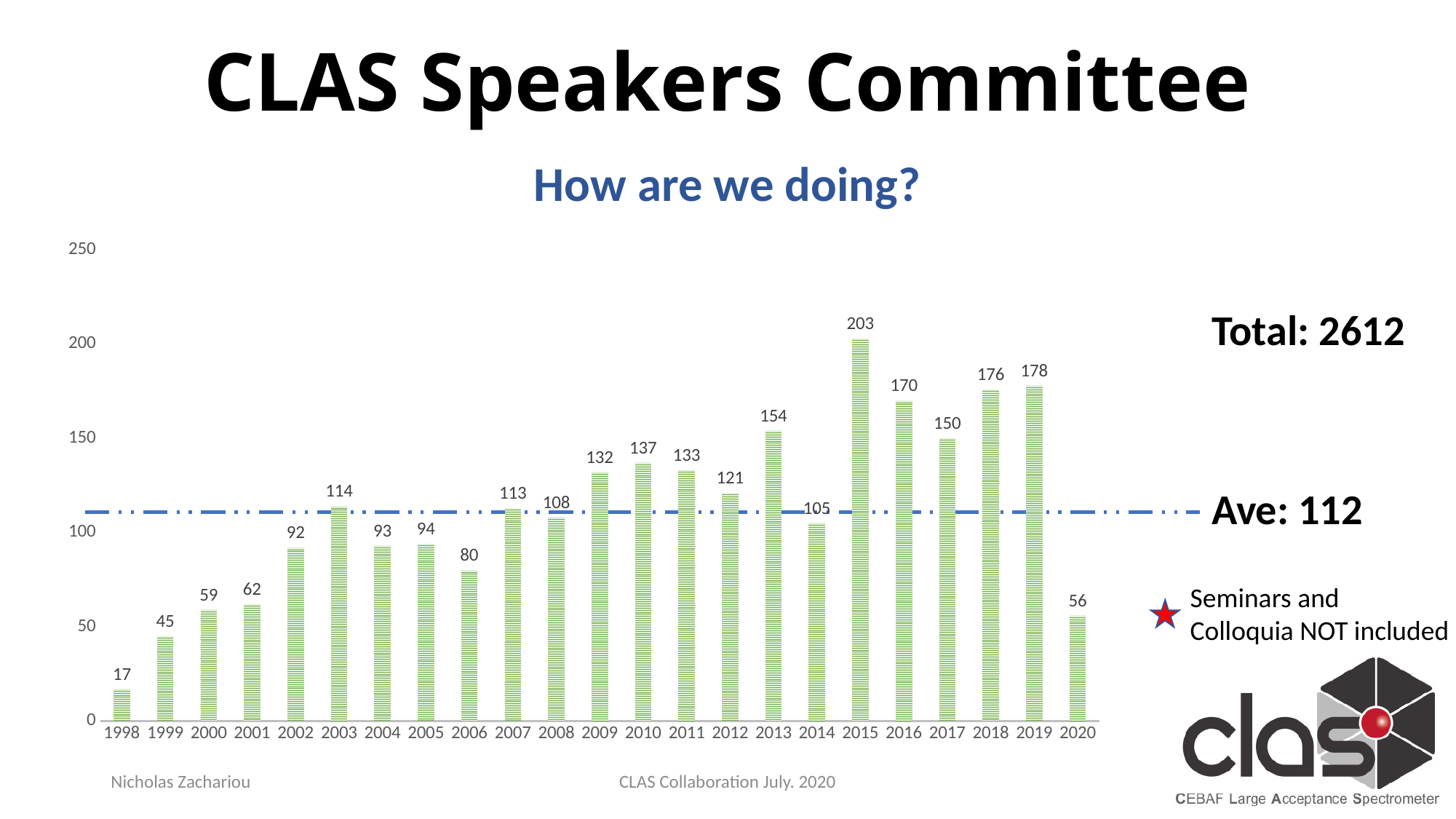
What is the value for 2020? 56 How many years are shown on the x axis? 23 What kind of chart is shown on the slide? bar chart Which year has the highest value? 2015 What is the value for 2015? 203 What is the difference between the values for 2019 and 2018? 2 Which is larger, the value for 2016 or the value for 2017? 2016 Which year has the lowest value? 1998 Is the value for 2013 greater or less than 150? greater Do the values rise or fall from 1998 to 2003? rise What is the value for 1998? 17 What average value is indicated by the dashed horizontal line? 112